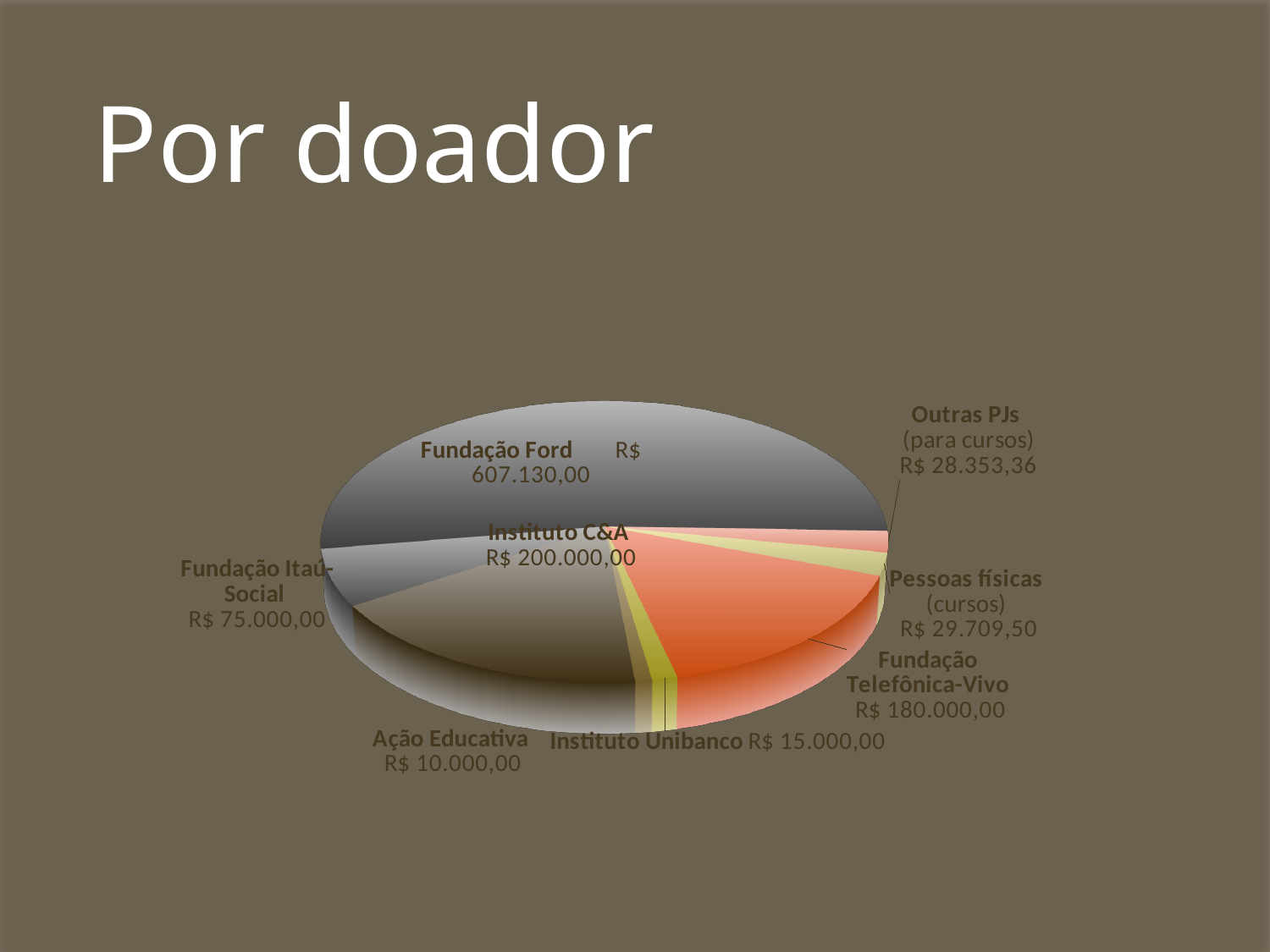
What kind of chart is shown on the slide? Pie chart Which is larger, the value for Instituto Unibanco or the value for Ação Educativa? Instituto Unibanco How many donor categories are shown in the pie chart? 8 What is the value for Fundação Ford? R$ 607.130,00 Which donor has the largest slice of the pie? Fundação Ford What is the value for Fundação Telefônica-Vivo? R$ 180.000,00 What is the value for Pessoas físicas (cursos)? R$ 29.709,50 Which donor has the smallest value? Ação Educativa What is the difference between the values for Fundação Ford and Instituto C&A? R$ 407.130,00 What is the value for Outras PJs (para cursos)? R$ 28.353,36 What is the value for Instituto C&A? R$ 200.000,00 What is the title of the slide containing the chart? Por doador